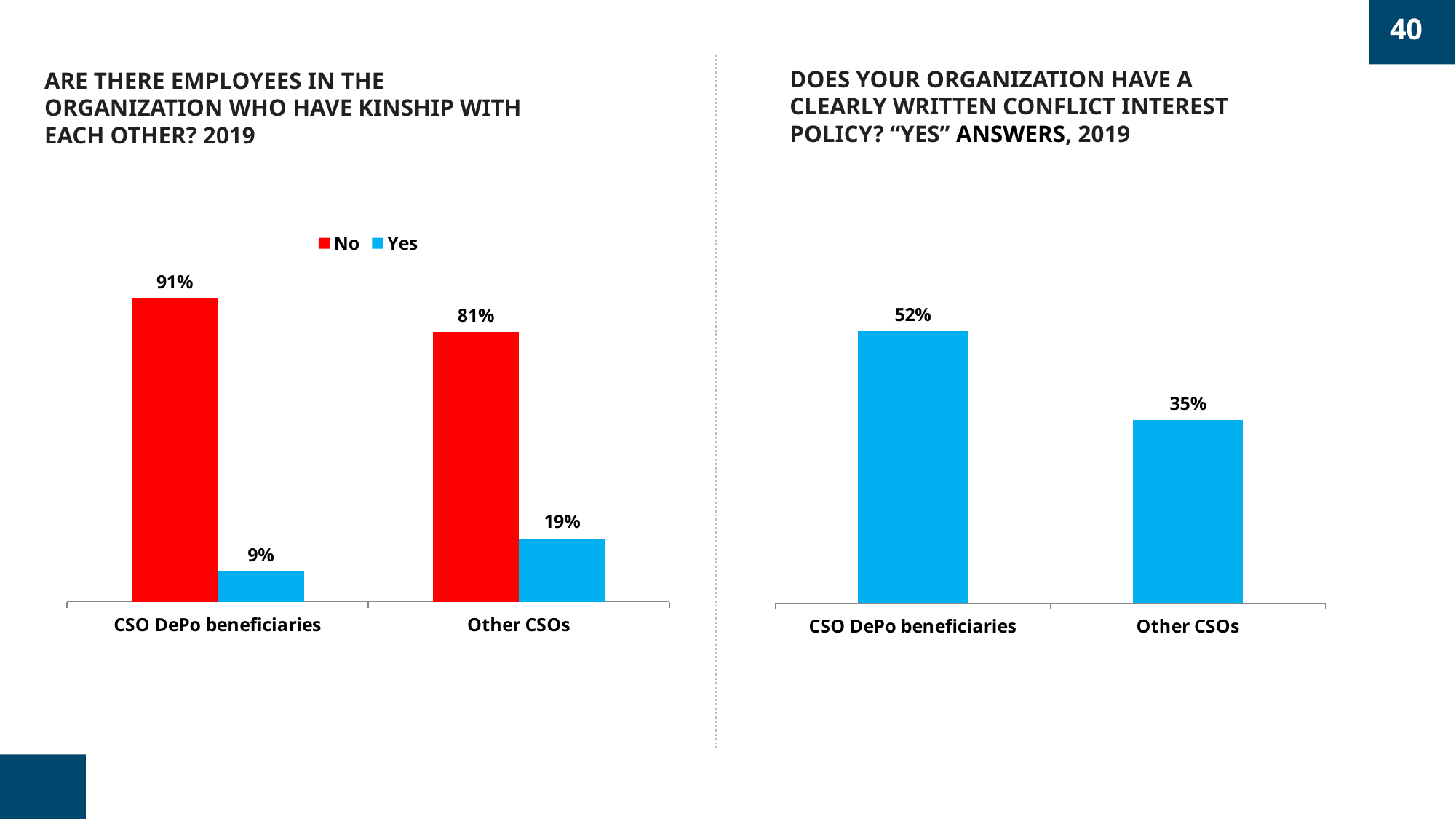
In the left chart (kinship among employees), is the 'No' value larger for CSO DePo beneficiaries or for Other CSOs? CSO DePo beneficiaries In the right chart (conflict of interest policy), what is the value for Other CSOs? 35% What type of chart is the right chart (conflict of interest policy)? Bar chart In the left chart (kinship among employees), what is the difference between the 'No' values for CSO DePo beneficiaries and Other CSOs? 10% In the right chart (conflict of interest policy), what is the value for CSO DePo beneficiaries? 52% In the left chart (kinship among employees), what is the 'Yes' value for CSO DePo beneficiaries? 9% In the left chart (kinship among employees), which bar is the lowest? Yes for CSO DePo beneficiaries In the right chart (conflict of interest policy), which category has the higher value? CSO DePo beneficiaries In the left chart (kinship among employees), what is the 'No' value for CSO DePo beneficiaries? 91% In the left chart (kinship among employees), what is the 'Yes' value for Other CSOs? 19% How many series does the legend of the left chart (kinship among employees) list? 2 In the right chart (conflict of interest policy), what is the difference between CSO DePo beneficiaries and Other CSOs? 17%